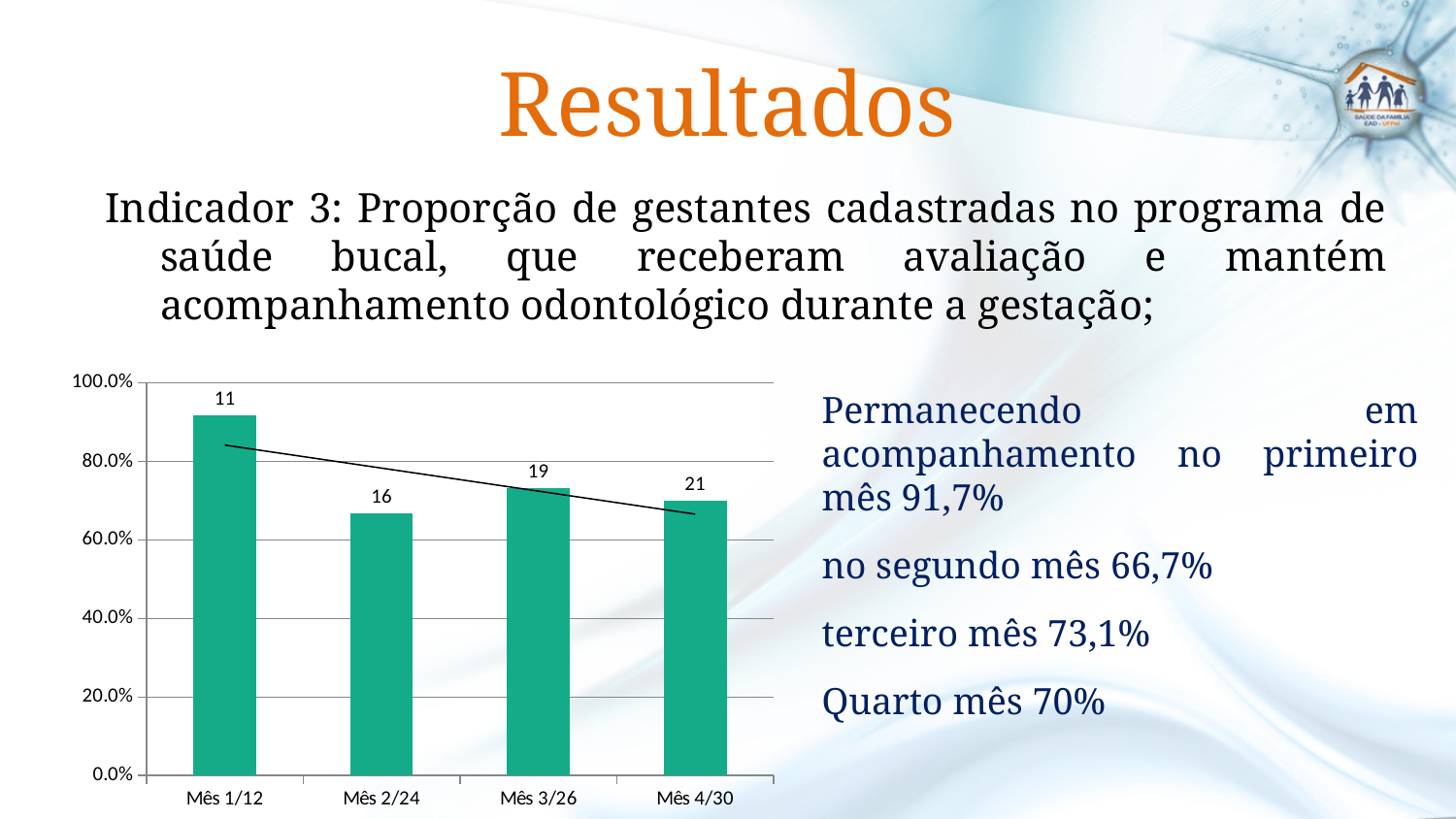
How many categories (bars) does the chart show? 4 Is the bar for Mês 2/24 greater or less than 80.0%? less Which bar is taller, Mês 1/12 or Mês 2/24? Mês 1/12 Which category has the tallest bar? Mês 1/12 What is the data label shown above the bar for Mês 2/24? 16 What is the data label shown above the bar for Mês 4/30? 21 Is the bar for Mês 1/12 greater or less than 80.0%? greater What is the data label shown above the bar for Mês 1/12? 11 What type of chart is shown on the slide? bar chart What is the difference between the data labels for Mês 4/30 and Mês 1/12? 10 What is the data label shown above the bar for Mês 3/26? 19 Is the bar for Mês 3/26 greater or less than 60.0%? greater